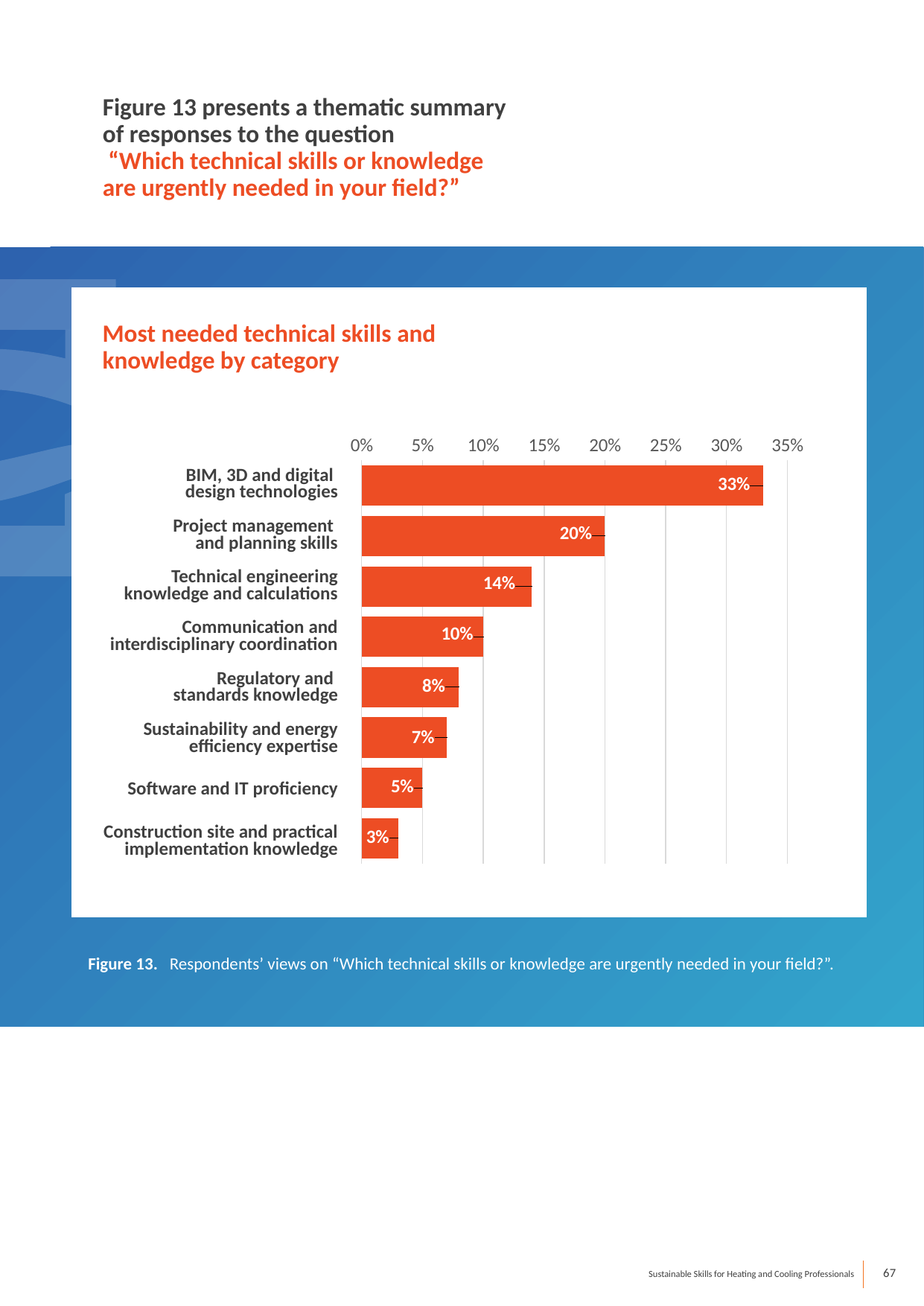
What is the value for Software and IT proficiency? 5% What is the value for BIM, 3D and digital design technologies? 33% Which category has the highest value? BIM, 3D and digital design technologies How many categories are shown in the chart? 8 What is the value for Project management and planning skills? 20% What is the difference between the values for BIM, 3D and digital design technologies and Project management and planning skills? 13% What is the value for Regulatory and standards knowledge? 8% What is the difference between the values for Technical engineering knowledge and calculations and Communication and interdisciplinary coordination? 4% What is the title of the chart? Most needed technical skills and knowledge by category Which is larger, the value for Sustainability and energy efficiency expertise or the value for Regulatory and standards knowledge? Regulatory and standards knowledge Which category has the lowest value? Construction site and practical implementation knowledge What kind of chart is shown on the slide? Bar chart